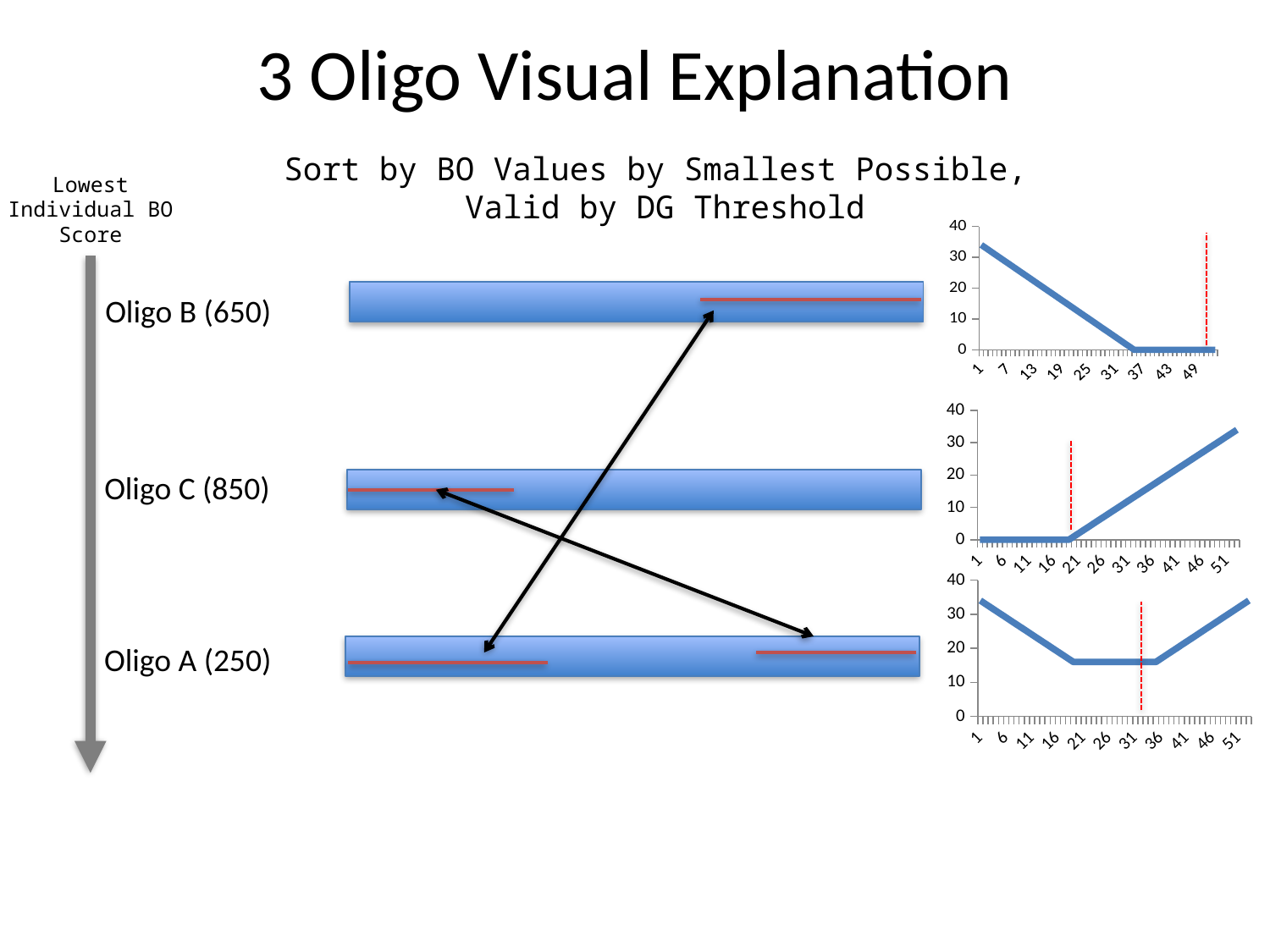
In the top chart on the right, is the value at x = 43 greater or less than 10? less What is the highest value shown on the y axis of the bottom chart on the right? 40 How many small charts are shown on the right side of the slide? 3 What kind of chart is the top chart on the right side of the slide? line chart In the middle chart on the right, is the value at x = 11 greater or less than 10? less In the bottom chart on the right, do the values rise or fall as the x axis goes from 1 to 21? fall In the middle chart on the right, do the values rise or fall as the x axis goes from 21 to 51? rise In the top chart on the right, is the value at x = 1 greater or less than 20? greater In the top chart on the right, do the values rise or fall as the x axis goes from 1 to 37? fall What colour is the dashed vertical line in each of the three charts on the right? red